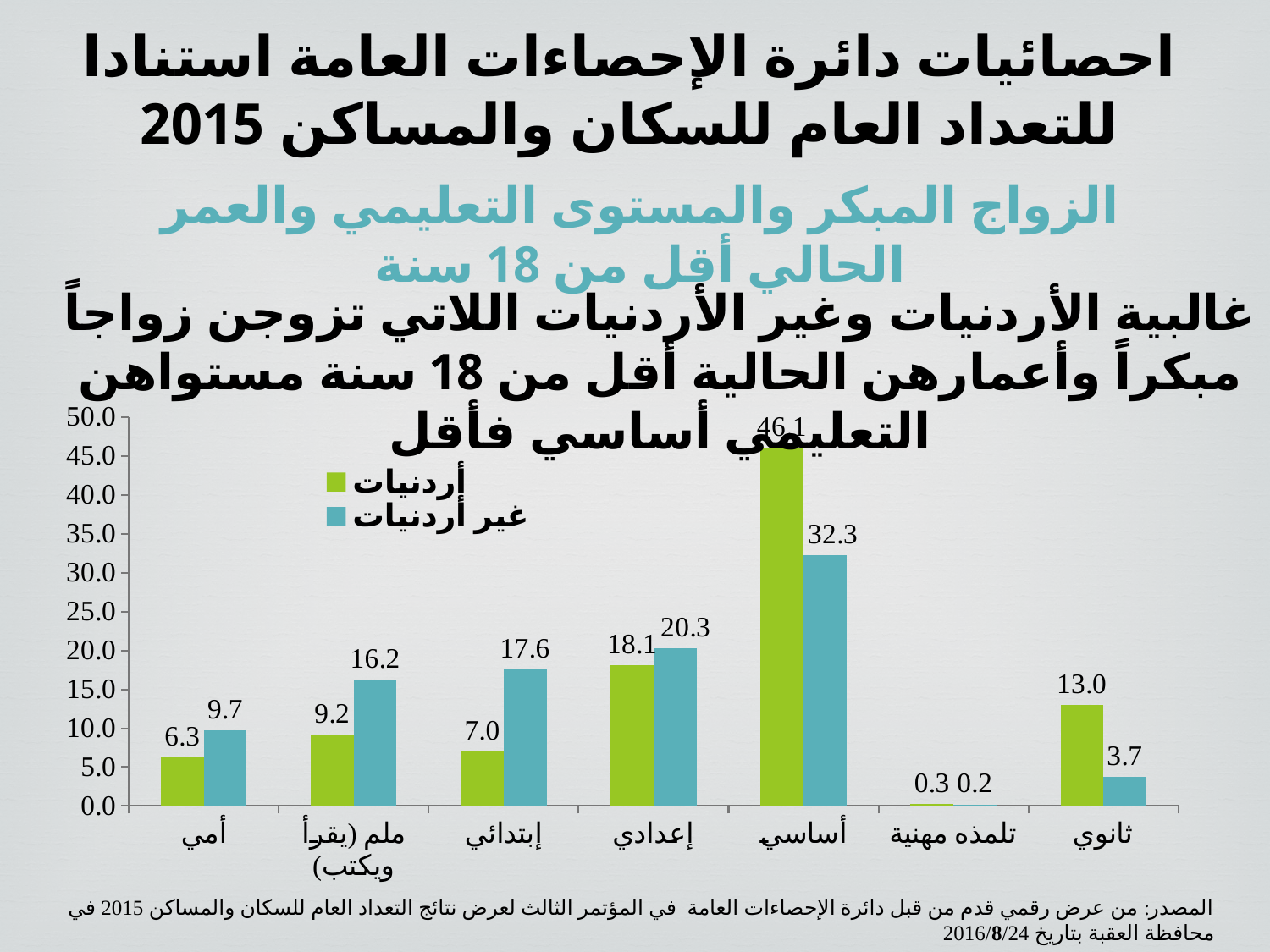
Is the value for غير أردنيات in the إعدادي category greater or less than 15.0? greater In the ثانوي category, which series has the larger value, أردنيات or غير أردنيات? أردنيات What type of chart is shown on the slide? bar chart Which colour represents the غير أردنيات series in the chart? blue What is the value for أردنيات in the أساسي category? 46.1 How many categories are shown on the x axis of the chart? 7 Which category has the highest value for غير أردنيات? أساسي What is the value for غير أردنيات in the إبتدائي category? 17.6 How many series does the chart legend list? 2 What is the value for أردنيات in the ثانوي category? 13.0 Which category has the lowest value for أردنيات? تلمذه مهنية What is the difference between the غير أردنيات and أردنيات values in the ملم (يقرأ ويكتب) category? 7.0